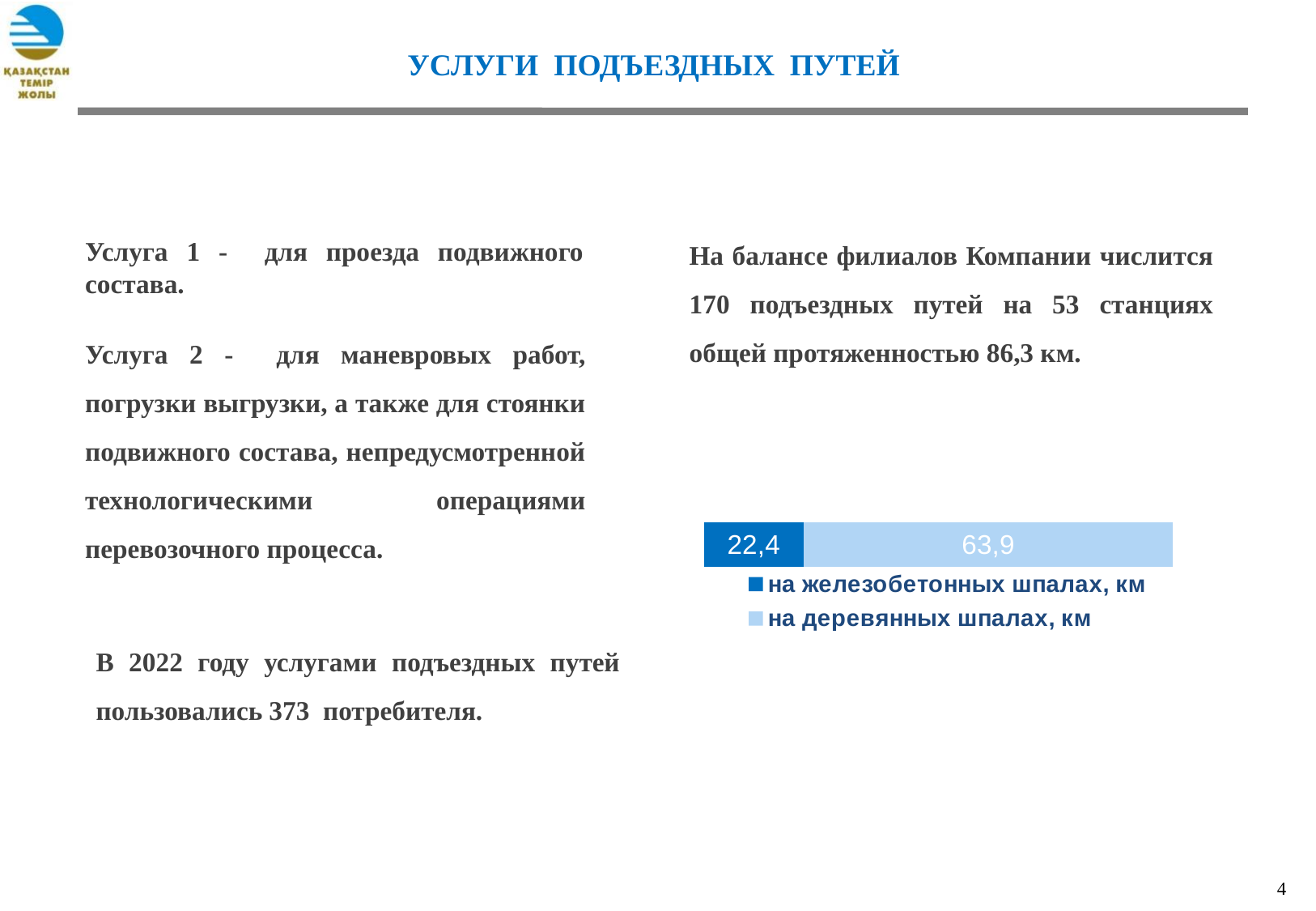
Which series is shown in light blue in the chart? на деревянных шпалах, км Which series has the smaller value in the chart? на железобетонных шпалах, км How many series does the chart legend list? 2 What is the total of the stacked bar in the chart? 86,3 What is the value for "на железобетонных шпалах, км" in the chart? 22,4 What is the value for "на деревянных шпалах, км" in the chart? 63,9 Which series has the larger value in the chart? на деревянных шпалах, км What is the difference between the value for "на деревянных шпалах, км" and the value for "на железобетонных шпалах, км"? 41,5 Which series is shown in dark blue in the chart? на железобетонных шпалах, км What kind of chart is shown on the slide? stacked bar chart Is the value for "на железобетонных шпалах, км" larger or smaller than the value for "на деревянных шпалах, км"? smaller